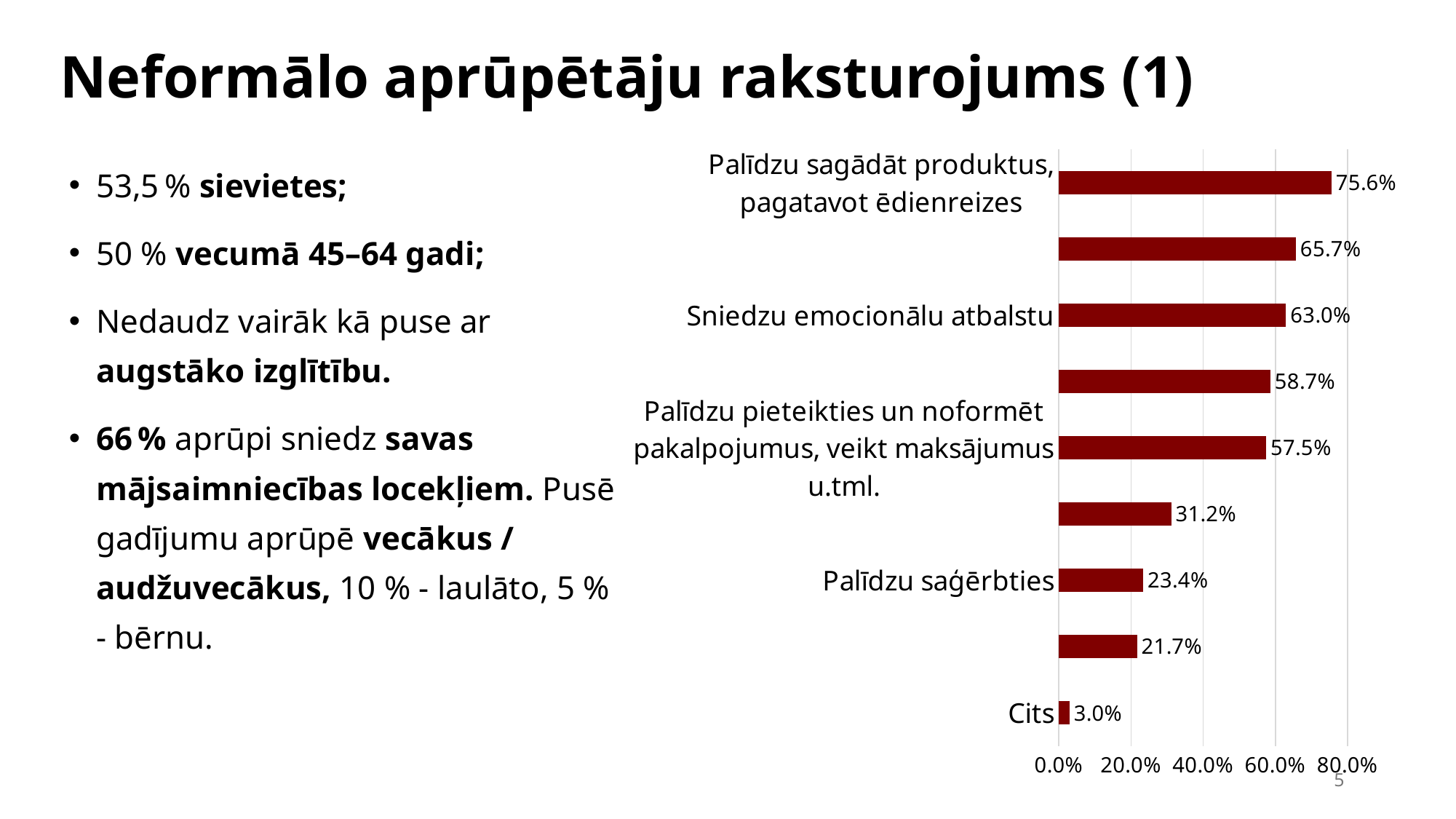
What is the value for "Palīdzu saģērbties"? 23.4% Which is larger: the value for "Sniedzu emocionālu atbalstu" or the value for "Palīdzu pieteikties un noformēt pakalpojumus, veikt maksājumus u.tml."? Sniedzu emocionālu atbalstu What is the value for "Cits"? 3.0% What is the difference between the values for "Sniedzu emocionālu atbalstu" and "Palīdzu saģērbties"? 39.6% What kind of chart is shown on the slide? bar chart Which category has the highest value? Palīdzu sagādāt produktus, pagatavot ēdienreizes How many bars are plotted in the chart? 9 What is the value for "Palīdzu pieteikties un noformēt pakalpojumus, veikt maksājumus u.tml."? 57.5% Is the value for "Palīdzu saģērbties" greater or less than 40.0%? less Which category has the lowest value? Cits What is the value for "Palīdzu sagādāt produktus, pagatavot ēdienreizes"? 75.6% What is the value for "Sniedzu emocionālu atbalstu"? 63.0%